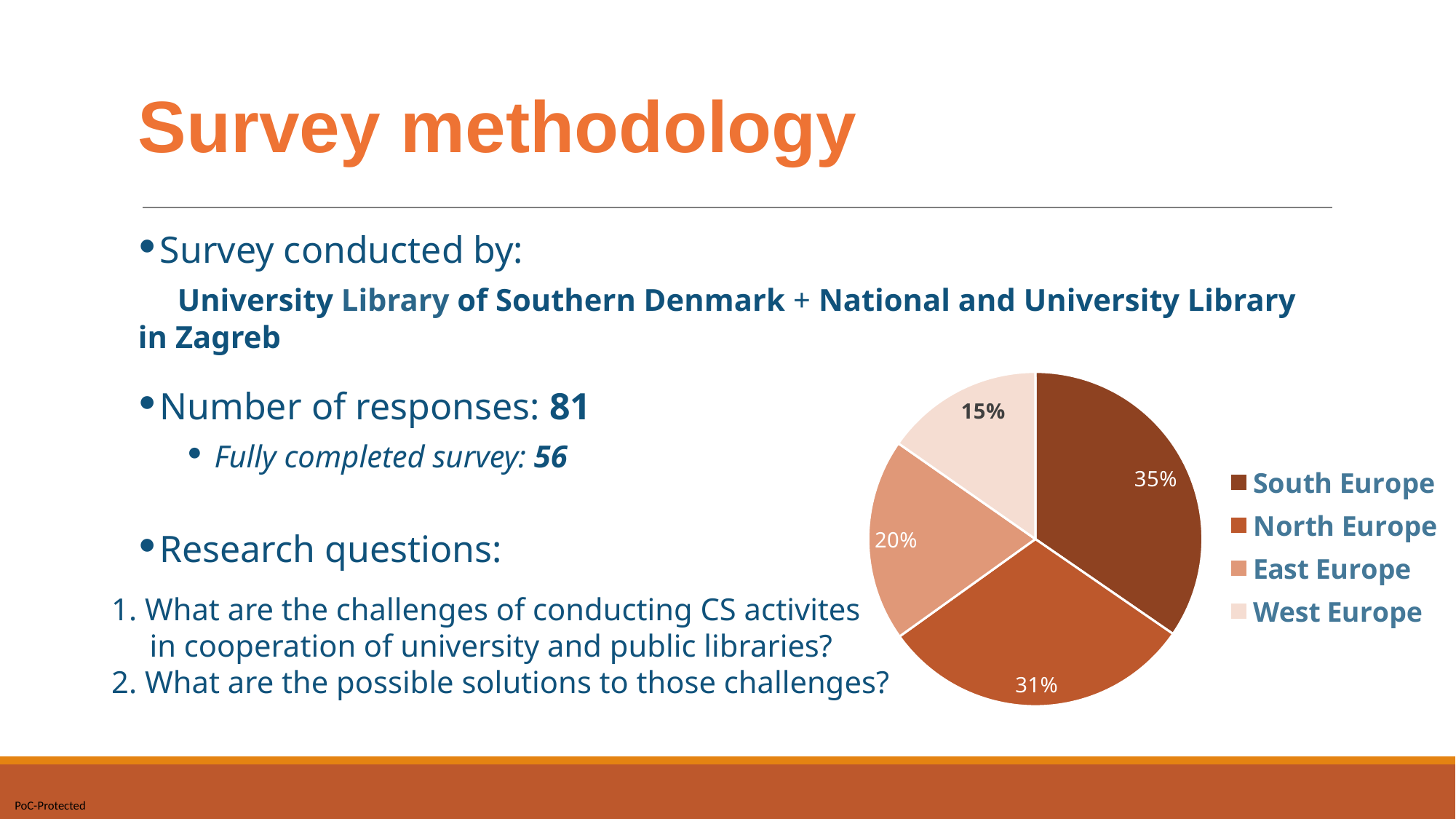
How many slices does the pie chart have? 4 How many entries does the legend list? 4 What kind of chart is shown on the slide? pie chart What share of the pie does South Europe have? 35% Which region has the smallest slice of the pie? West Europe What share of the pie does North Europe have? 31% What share of the pie does West Europe have? 15% What is the difference in percentage points between North Europe and East Europe? 11 Which is larger, the share for East Europe or the share for North Europe? North Europe Which region has the largest slice of the pie? South Europe What is the difference in percentage points between South Europe and West Europe? 20 What share of the pie does East Europe have? 20%